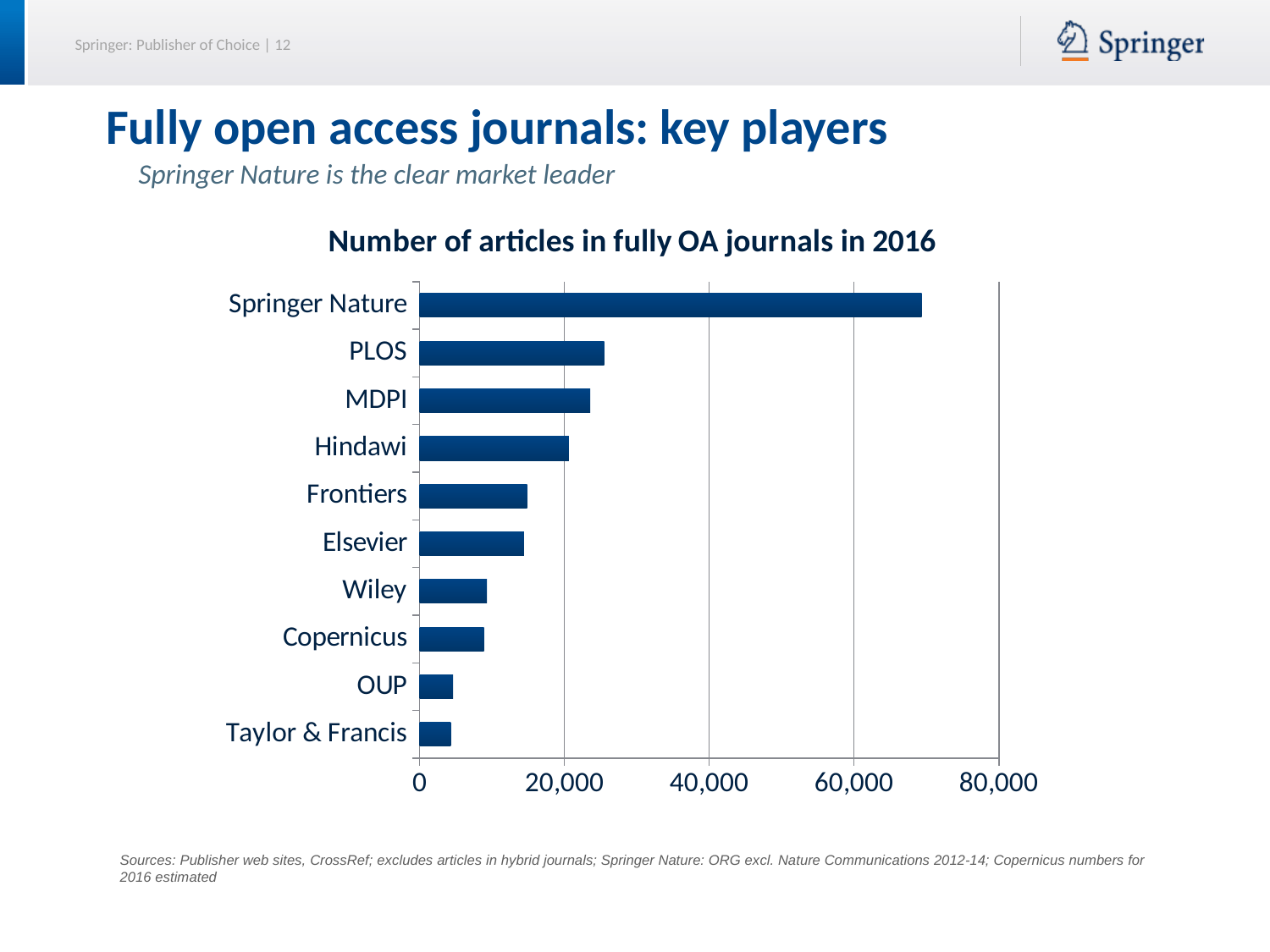
What type of chart is shown on the slide? Bar chart Is the value for OUP greater or less than 20,000? less How many publishers are shown in the chart? 10 Is the value for PLOS greater or less than 20,000? greater Which has more articles in fully OA journals, Frontiers or Wiley? Frontiers Which has more articles in fully OA journals, Springer Nature or PLOS? Springer Nature What is the title of the chart? Number of articles in fully OA journals in 2016 Is the value for Springer Nature greater or less than 80,000? less Which has more articles in fully OA journals, PLOS or Hindawi? PLOS Which publisher has the highest number of articles in fully OA journals in 2016? Springer Nature